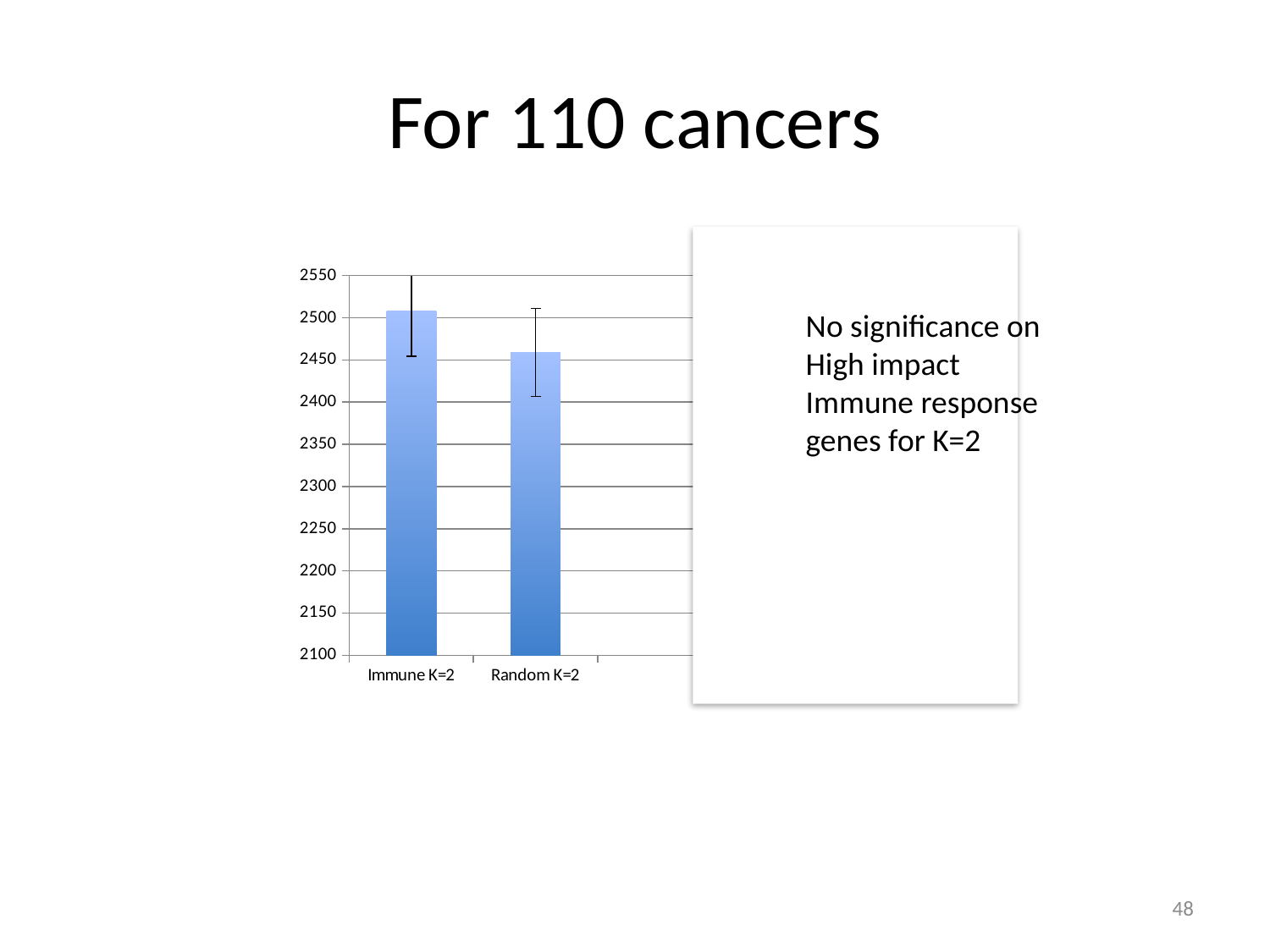
Which category has the lowest bar in the chart? Random K=2 Which bar is taller, Immune K=2 or Random K=2? Immune K=2 What is the lowest value shown on the y axis of the chart? 2100 Is the value for Random K=2 greater or less than 2400? greater Is the value for Random K=2 greater or less than 2500? less What kind of chart is shown on the slide? bar chart Is the value for Immune K=2 greater or less than 2450? greater Which category has the highest bar in the chart? Immune K=2 What is the highest value shown on the y axis of the chart? 2550 How many bars are plotted in the chart? 2